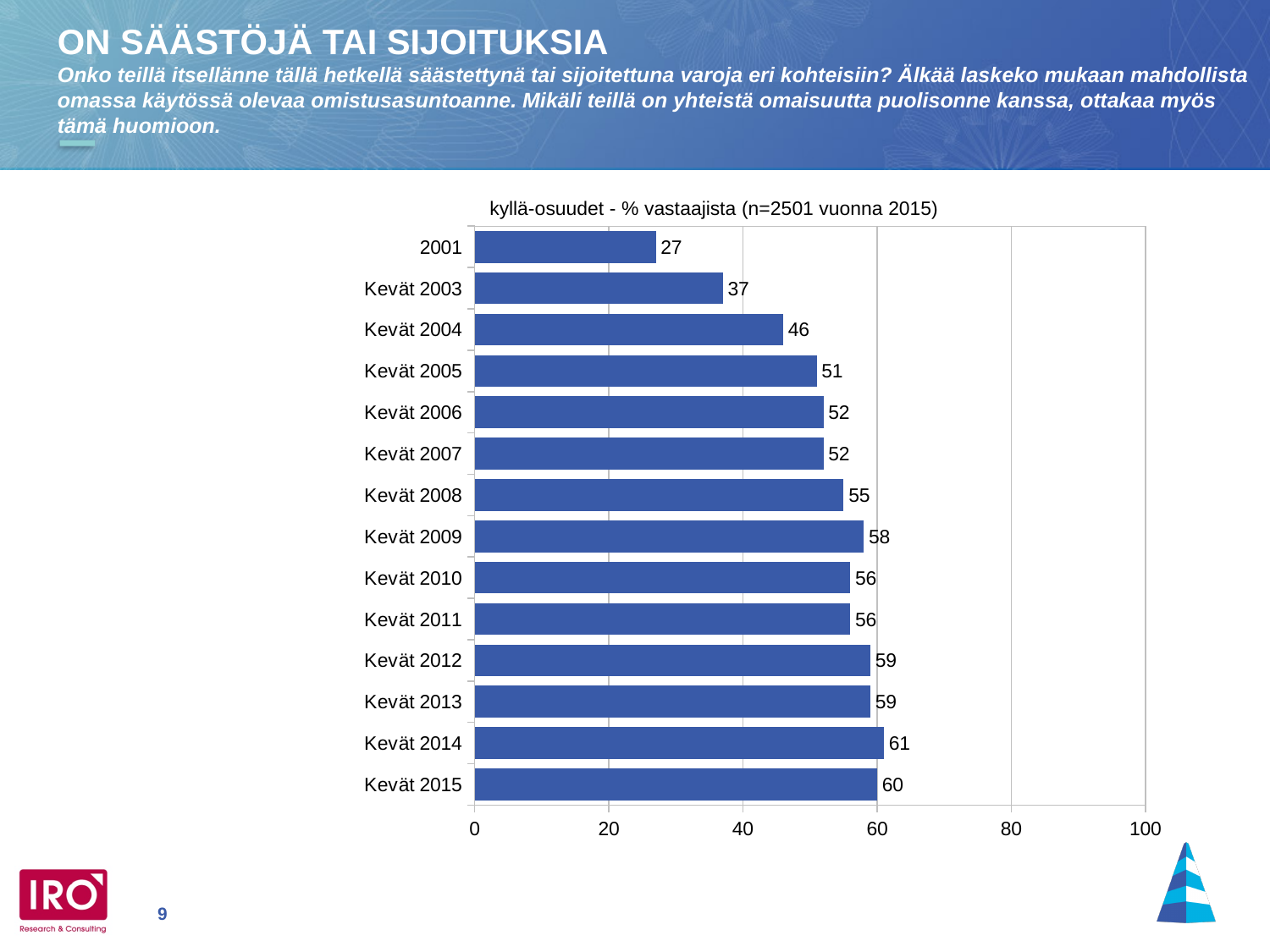
What kind of chart is shown on the slide? bar chart Which category has the highest value? Kevät 2014 Do the values generally rise or fall from 2001 to Kevät 2015? rise What is the value for Kevät 2008? 55 Which is larger, the value for Kevät 2009 or the value for Kevät 2010? Kevät 2009 What is the title of the chart? kyllä-osuudet - % vastaajista (n=2501 vuonna 2015) How many categories are shown in the chart? 14 What is the value for 2001? 27 What is the value for Kevät 2015? 60 Is the value for Kevät 2004 greater or less than 40? greater Which category has the lowest value? 2001 What is the difference between the values for Kevät 2015 and 2001? 33